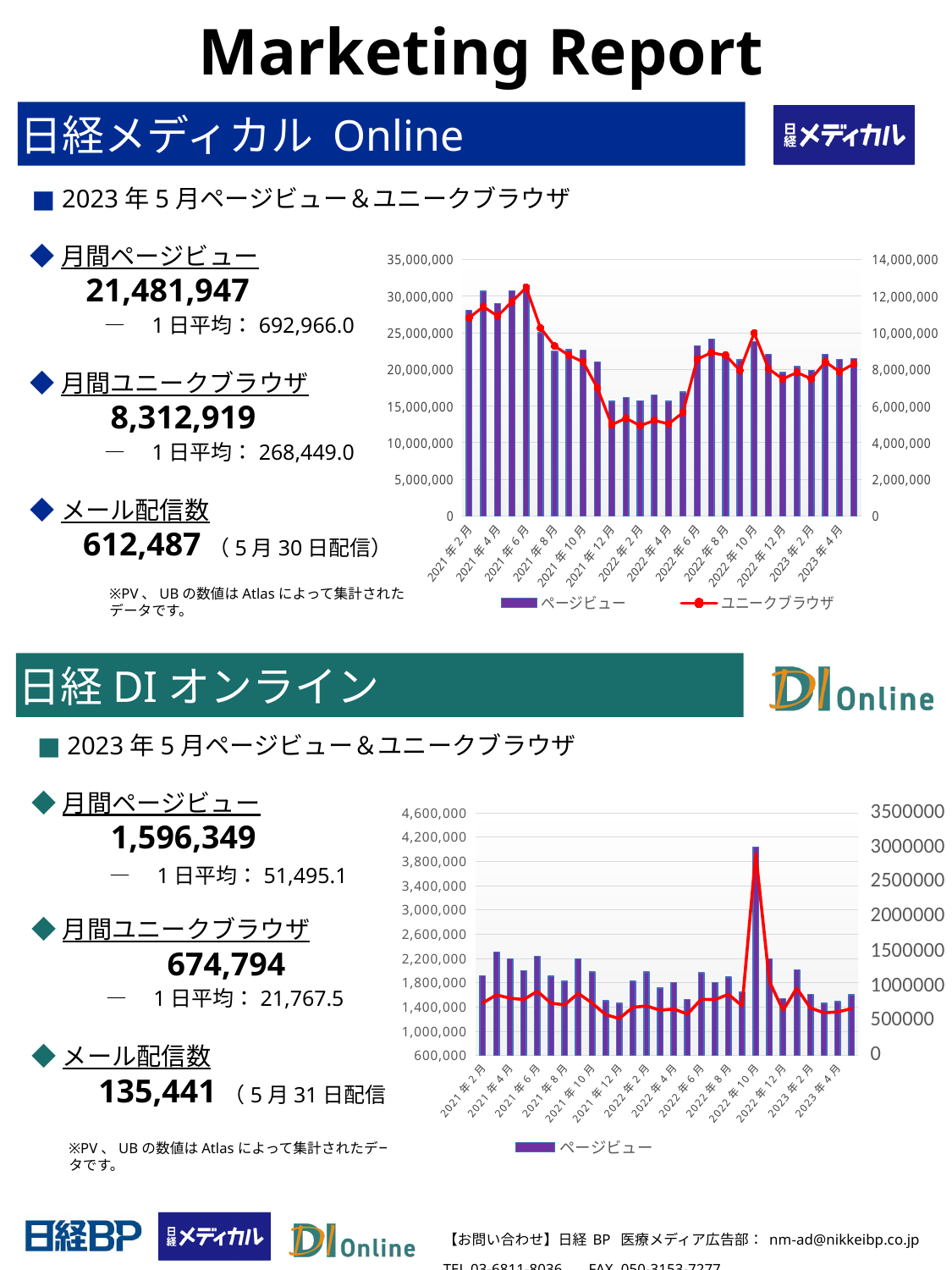
What kind of chart is shown for 日経メディカル Online (top chart)? Combination bar and line chart In the top chart (日経メディカル Online), do the ページビュー bars rise or fall from 2021年6月 to 2021年12月? fall How many series does the legend of the bottom chart (日経DIオンライン) list? 1 In the bottom chart (日経DIオンライン), is the ページビュー value for 2021年2月 greater or less than 2,200,000? less In the bottom chart (日経DIオンライン), is the ページビュー value for 2022年10月 greater or less than 3,400,000? greater In the top chart (日経メディカル Online), is the ページビュー value for 2022年2月 greater or less than 20,000,000? less In the top chart (日経メディカル Online), which is larger, the ページビュー value for 2021年6月 or for 2022年2月? 2021年6月 In the bottom chart (日経DIオンライン), do the ページビュー bars rise or fall from 2022年10月 to 2023年4月? fall In the bottom chart (日経DIオンライン), which month has the highest ページビュー bar? 2022年10月 What is the maximum value shown on the right-hand axis of the top chart (日経メディカル Online)? 14,000,000 How many series does the legend of the top chart (日経メディカル Online) list? 2